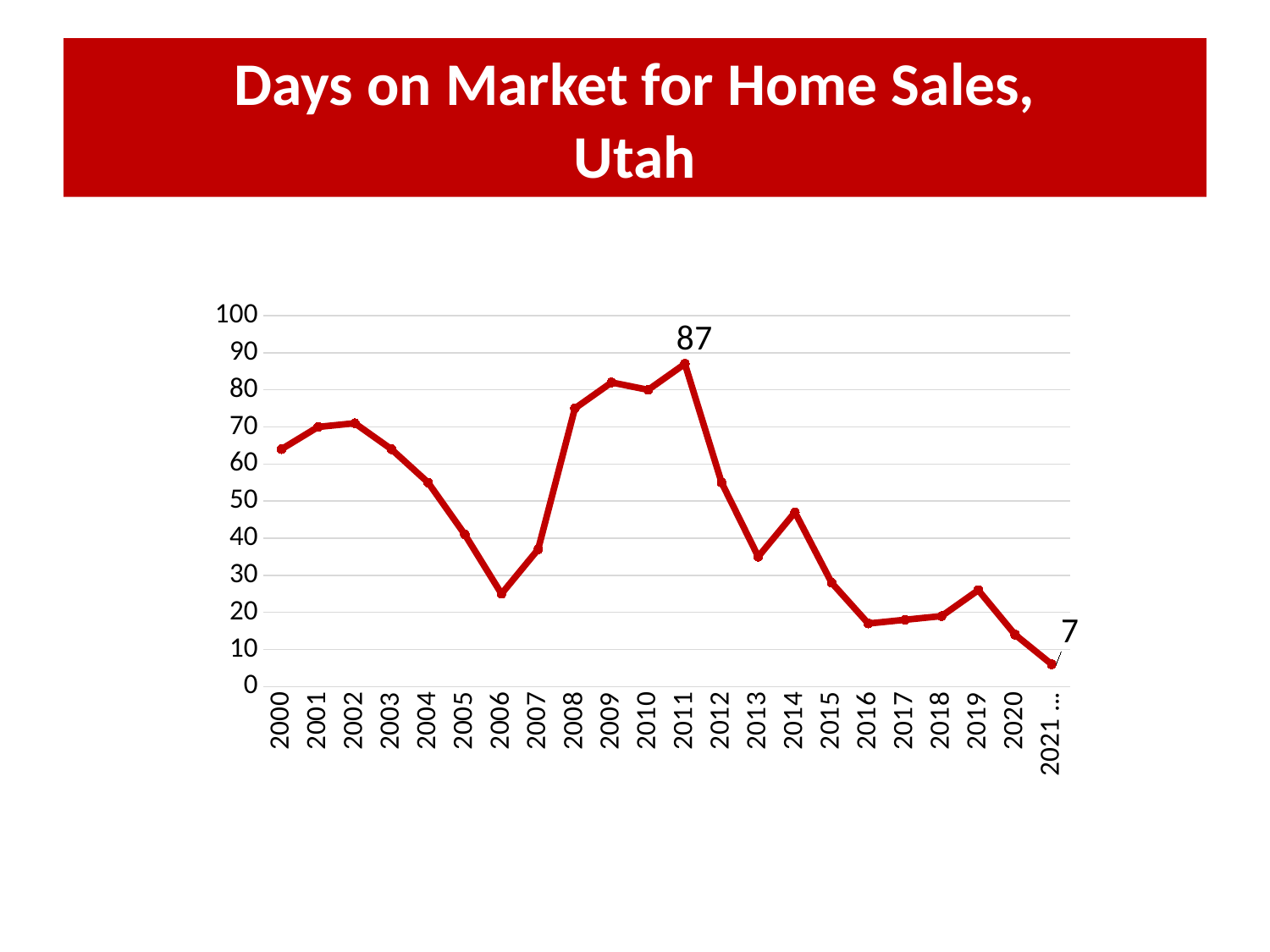
Which year has the lowest days on market? 2021 What kind of chart is shown on the slide? Line chart What is the difference between the values for 2011 and 2021? 80 How many years are plotted on the x axis? 22 Which year has the highest days on market? 2011 Is the value for 2014 greater or less than 40? greater Do the values rise or fall from 2011 to 2013? Fall What is the value for 2011? 87 What is the value for 2021? 7 Is the value for 2006 greater or less than 30? less Which is larger, the value for 2009 or the value for 2013? 2009 What is the title of the chart? Days on Market for Home Sales, Utah